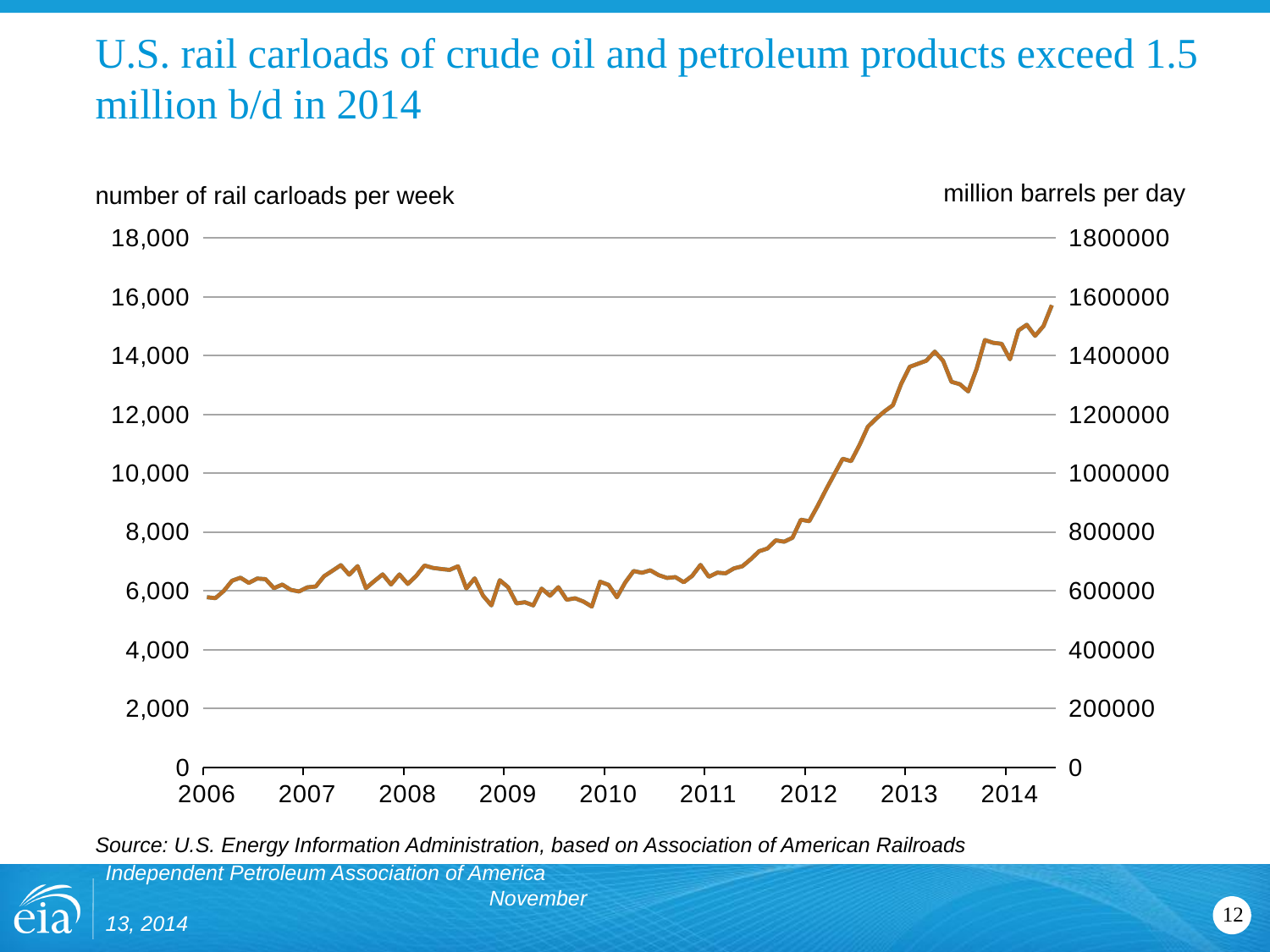
Is the value at the start of 2010 greater or less than 8,000 rail carloads per week? less Is the value at the end of 2014 greater or less than 16,000 rail carloads per week? less How many year labels are shown along the x axis? 9 Overall, do the values rise or fall from 2006 to 2014? rise What is the label of the left vertical axis? number of rail carloads per week Is the value at the end of 2014 greater or less than 14,000 rail carloads per week? greater What is the title of the chart on the slide? U.S. rail carloads of crude oil and petroleum products exceed 1.5 million b/d in 2014 In which year does the line reach its highest value? 2014 Which is larger, the value at the start of 2013 or the value at the start of 2011? the value at the start of 2013 How many lines are plotted on the chart? 1 What kind of chart is shown on the slide? line chart